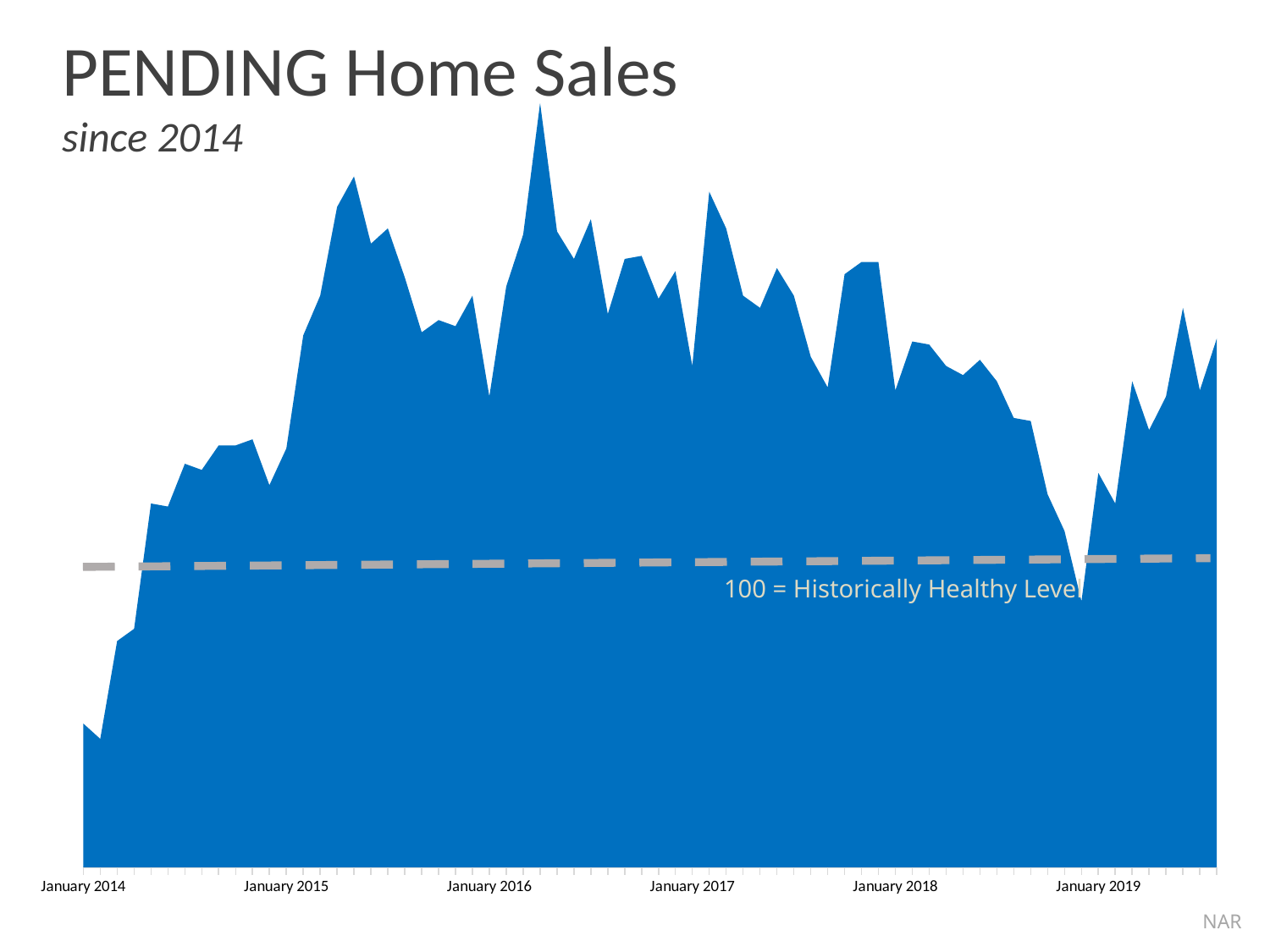
Is the value for January 2015 greater or less than 100? greater Is the value for January 2017 greater or less than 100? greater Is the value for January 2016 greater or less than 100? greater Do the values rise or fall between January 2018 and January 2019? fall What is the title of the chart? PENDING Home Sales since 2014 What does the dashed horizontal line on the chart represent? 100 = Historically Healthy Level How many year labels are shown on the x axis? 6 What kind of chart is shown on the slide? Area chart Do the values rise or fall between January 2014 and January 2015? rise Which is larger, the value for January 2014 or the value for January 2016? January 2016